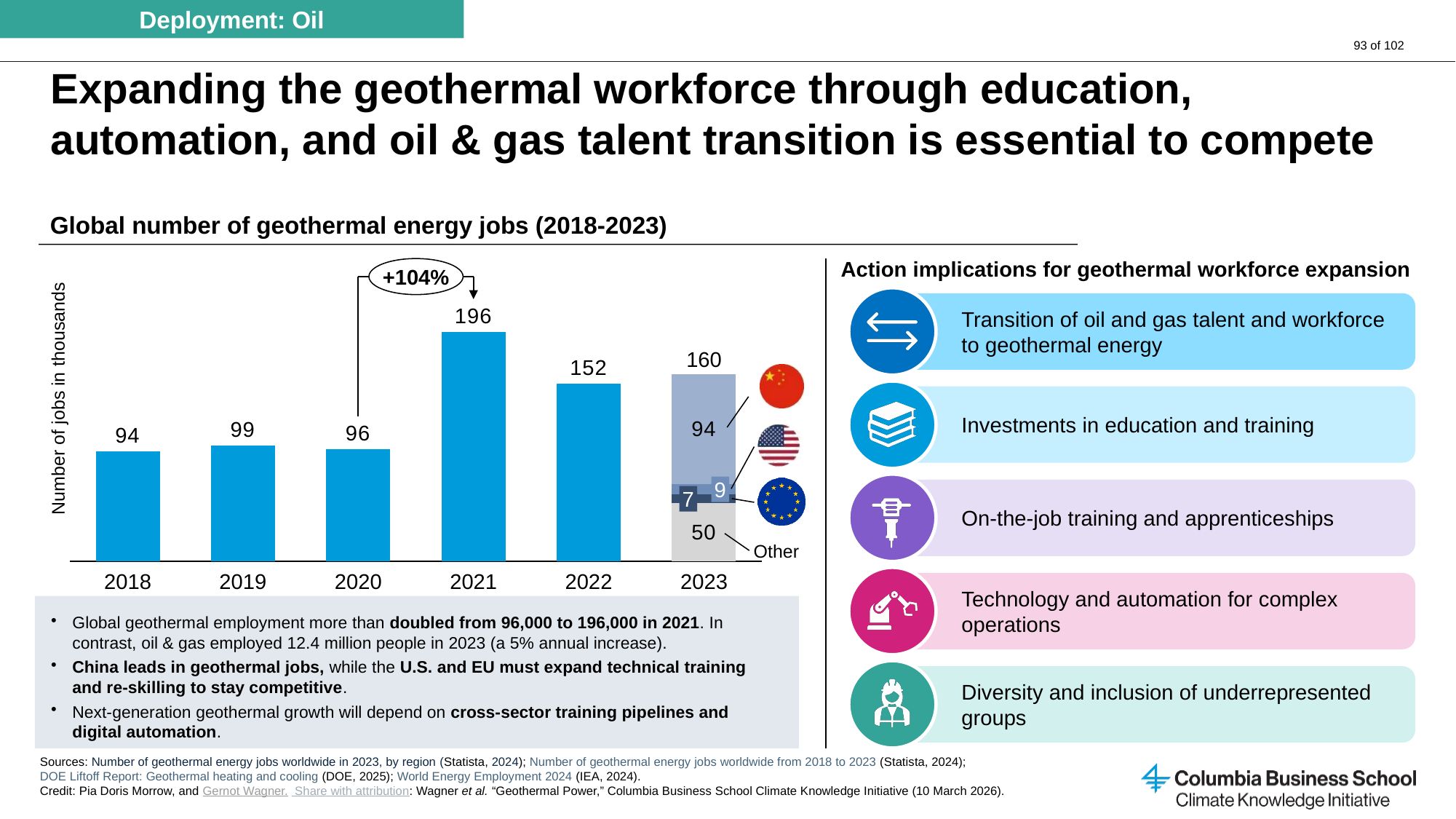
In the 2023 stacked bar, how many thousand geothermal jobs are attributed to China? 94 What is the difference between the 2021 and 2020 values in the geothermal jobs chart? 100 What percentage change is annotated between 2020 and 2021 in the chart? +104% Which year has the highest number of geothermal energy jobs in the chart? 2021 Which year has the lowest number of geothermal energy jobs in the chart? 2018 What kind of chart is used to show the global number of geothermal energy jobs? Bar chart How many years are shown on the x axis of the geothermal jobs chart? 6 Which year has a larger value in the chart, 2022 or 2023? 2023 What is the total of the 2023 stacked bar in the geothermal jobs chart? 160 What is the y-axis label of the geothermal jobs chart? Number of jobs in thousands What is the global number of geothermal energy jobs (in thousands) shown for 2021? 196 What is the value shown for 2018 in the geothermal jobs chart? 94